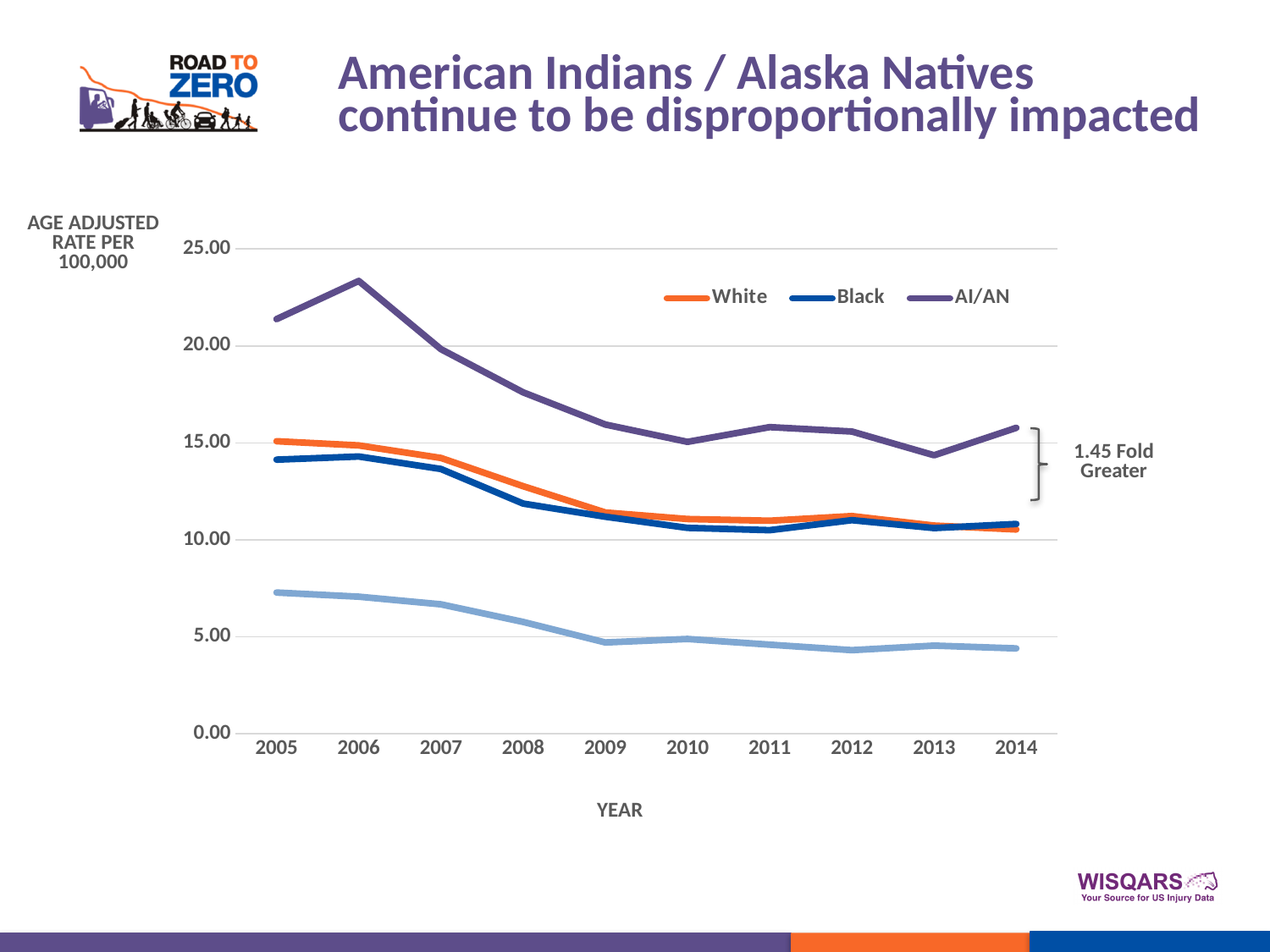
Is the Black value for 2005 greater or less than 15.00? less What kind of chart is shown on the slide? line chart Which series has the highest value in 2006? AI/AN What is the label on the x axis? YEAR How many series does the legend list? 3 How many years are shown along the x axis? 10 Is the AI/AN value for 2006 greater or less than 20.00? greater Is the White value for 2014 greater or less than 10.00? greater In which year does the AI/AN line reach its highest value? 2006 Does the AI/AN line rise or fall overall from 2005 to 2014? fall In 2008, which is larger, the White value or the Black value? White